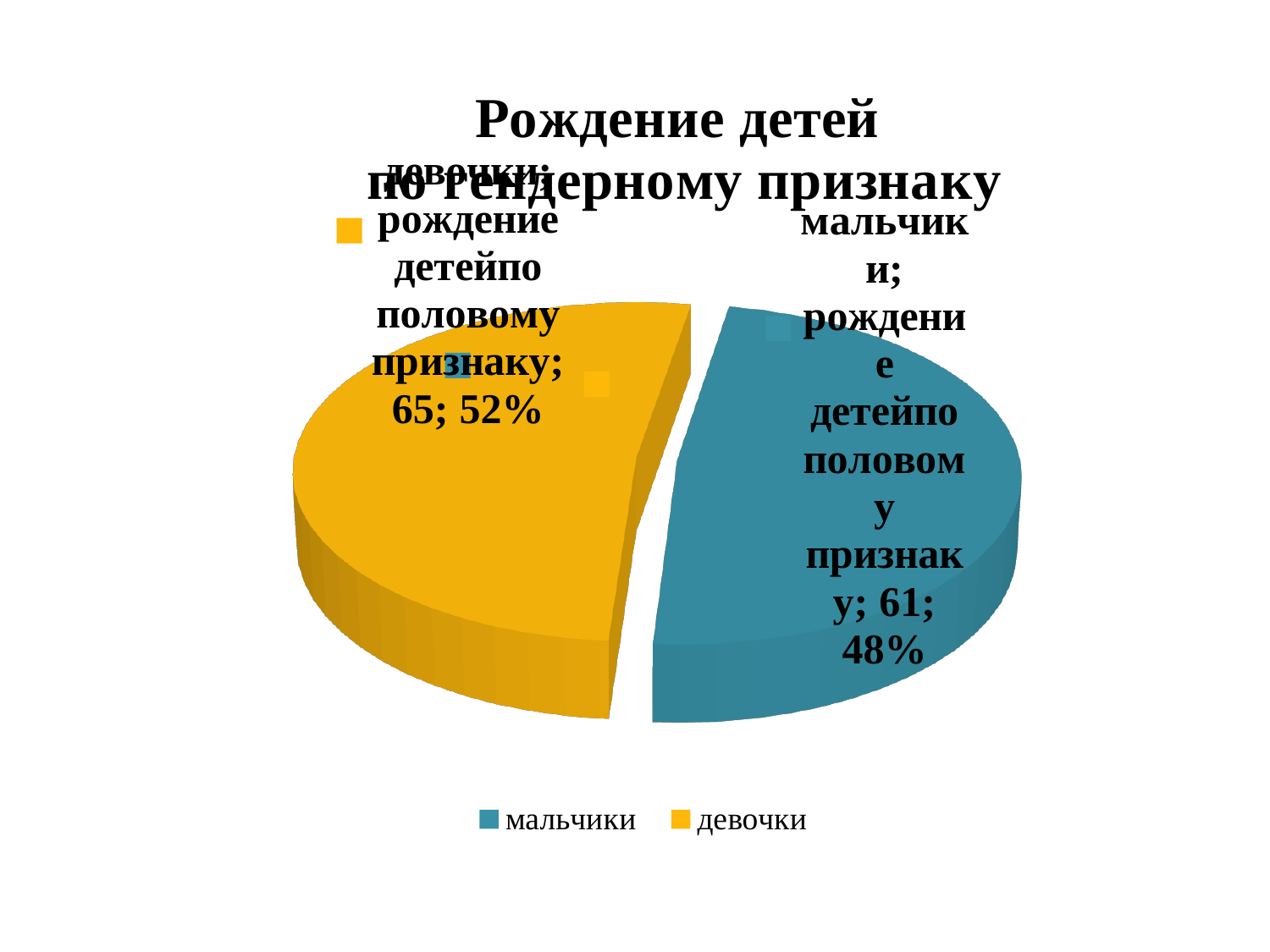
Which category has the largest slice? девочки What share of the pie does the девочки slice represent? 52% Which category has the smallest slice? мальчики What is the difference between the values for девочки and мальчики? 4 How many entries does the legend list? 2 What kind of chart is shown on the slide? pie chart What share of the pie does the мальчики slice represent? 48% What is the title of the chart? Рождение детей по гендерному признаку Which colour represents мальчики in the chart? blue (teal) What is the value for девочки? 65 What is the value for мальчики? 61 How many slices does the pie chart have? 2